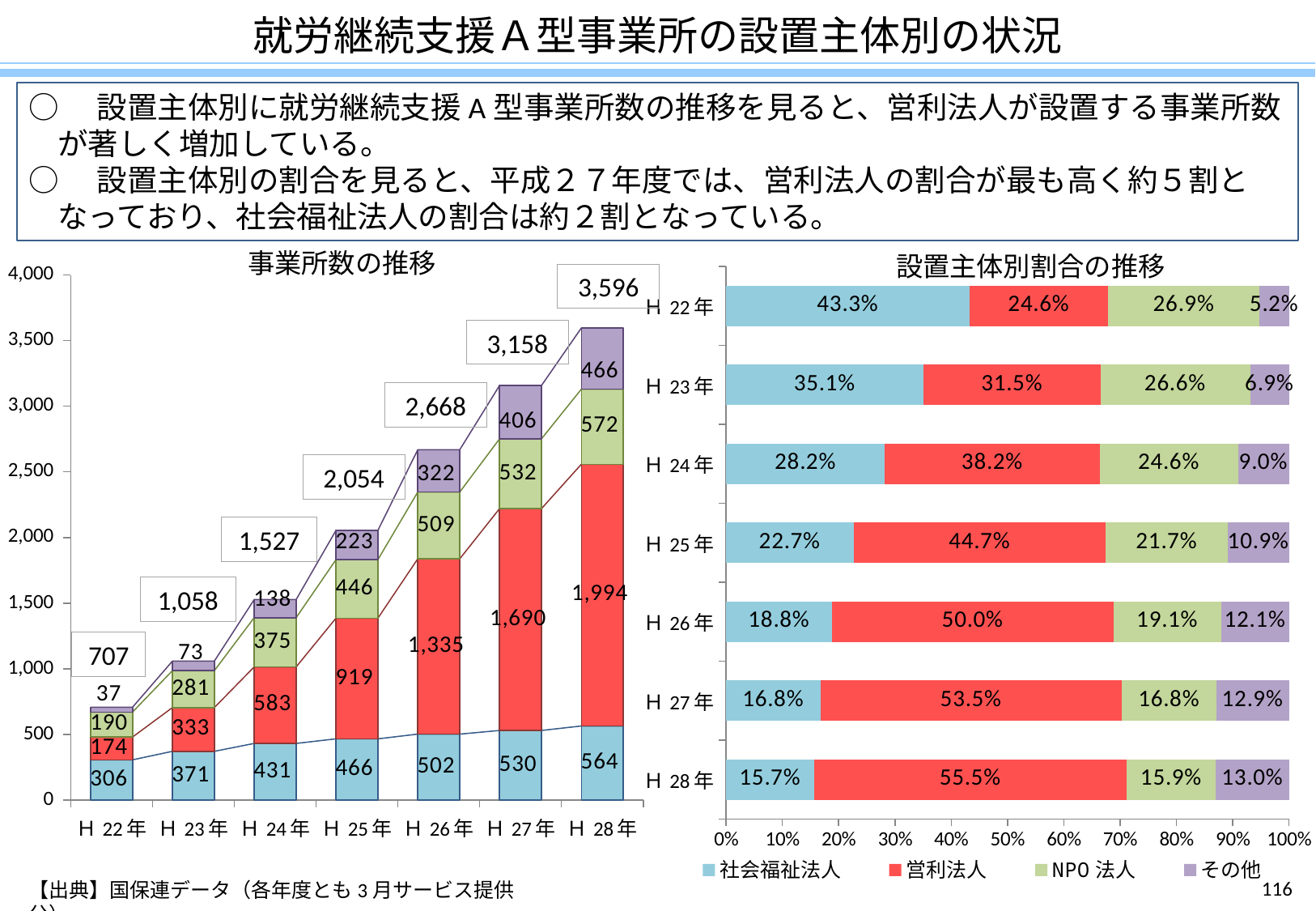
In the chart titled 設置主体別割合の推移, which year has the highest share for 社会福祉法人? H 22年 In the chart titled 事業所数の推移, what is the value for 営利法人 in H 26年? 1,335 What kind of chart is the chart titled 設置主体別割合の推移? stacked bar chart In the chart titled 設置主体別割合の推移, which year has the lowest share for その他? H 22年 In the chart titled 事業所数の推移, how many years are shown on the x axis? 7 In the chart titled 事業所数の推移, what is the total number of establishments shown for H 28年? 3,596 In the chart titled 設置主体別割合の推移, what is the share for 営利法人 in H 27年? 53.5% In the chart titled 設置主体別割合の推移, which is larger in H 24年: the share for 営利法人 or the share for NPO法人? 営利法人 How many series does the legend list? 4 In the chart titled 事業所数の推移, what is the value for 社会福祉法人 in H 22年? 306 In the chart titled 事業所数の推移, what is the difference between the 営利法人 values for H 28年 and H 27年? 304 In the chart titled 事業所数の推移, do the total values rise or fall from H 22年 to H 28年? rise